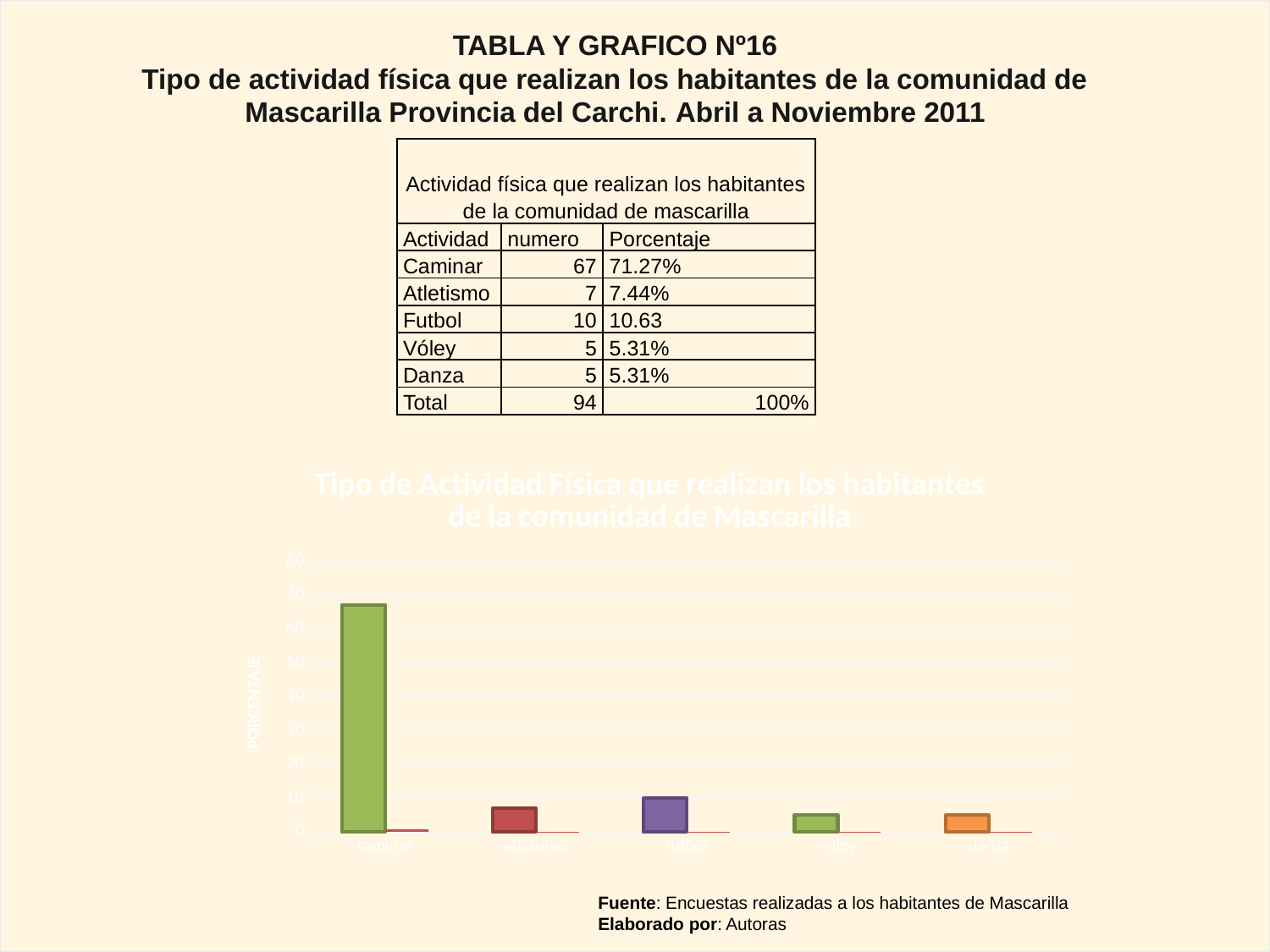
Which activity has the highest bar in the chart? caminar What is the highest value shown on the vertical axis of the chart? 80 Is the value for danza greater or less than 10? less What kind of chart is shown on the slide? bar chart Is the value for futbol greater or less than 20? less What is the label on the vertical axis of the chart? PORCENTAJE How many activity categories are plotted on the x axis of the chart? 5 Which bar is taller, caminar or futbol? caminar Is the value for caminar greater or less than 60? greater Which bar is taller, futbol or atletismo? futbol